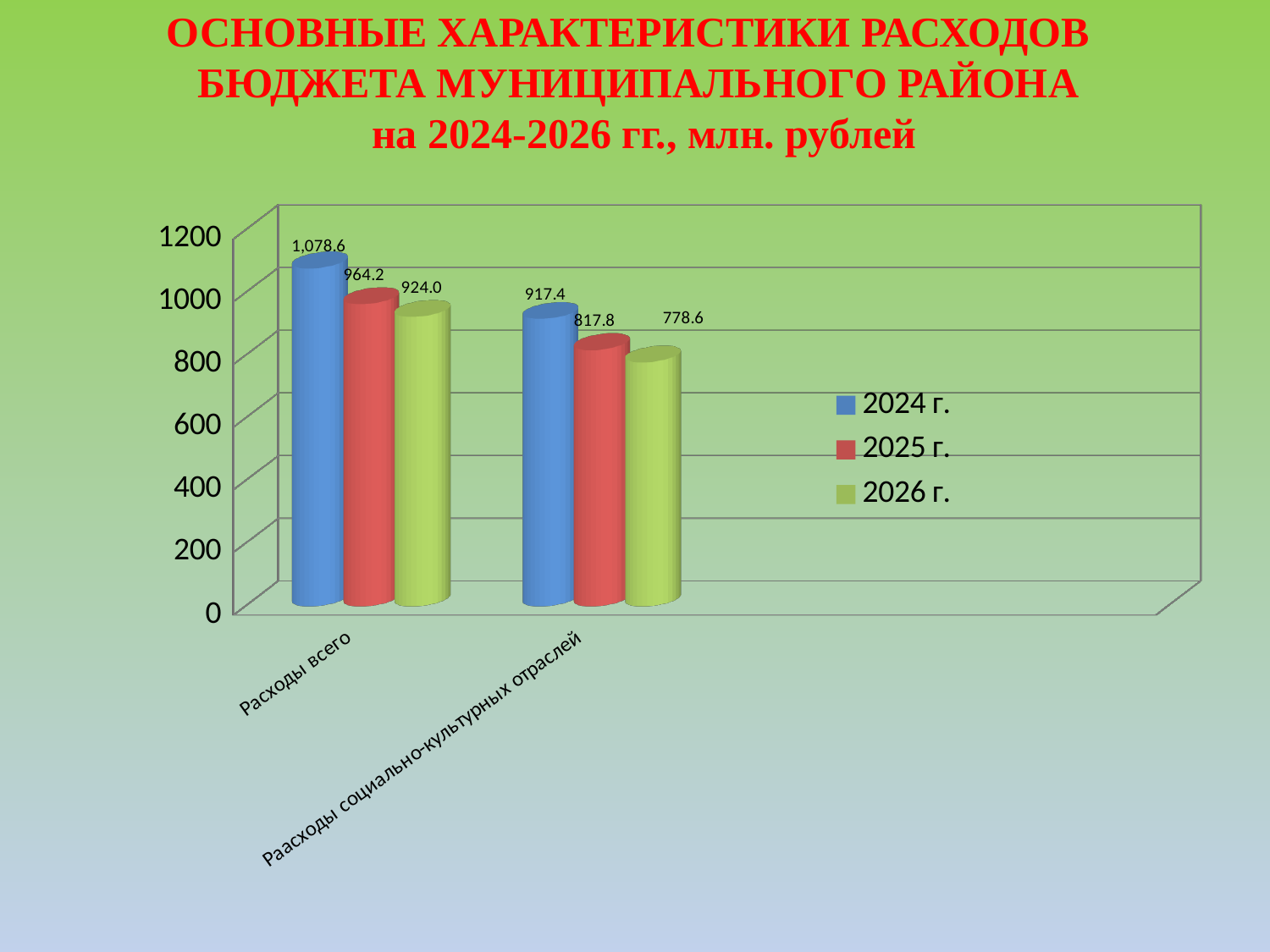
What is the value for 2025 г. in the category Раасходы социально-культурных отраслей? 817.8 What is the difference between the 2024 г. and 2026 г. values in the category Раасходы социально-культурных отраслей? 138.8 What is the difference between the 2024 г. and 2025 г. values in the category Расходы всего? 114.4 What is the value for 2024 г. in the category Расходы всего? 1,078.6 How many categories are shown on the x axis? 2 How many series does the legend list? 3 Which is larger: the 2025 г. value for Расходы всего or the 2024 г. value for Раасходы социально-культурных отраслей? 2025 г. value for Расходы всего Which year has the highest value in the category Расходы всего? 2024 г. Which year has the lowest value in the category Раасходы социально-культурных отраслей? 2026 г. What is the value for 2026 г. in the category Раасходы социально-культурных отраслей? 778.6 What is the value for 2026 г. in the category Расходы всего? 924.0 What kind of chart is shown on the slide? Bar chart